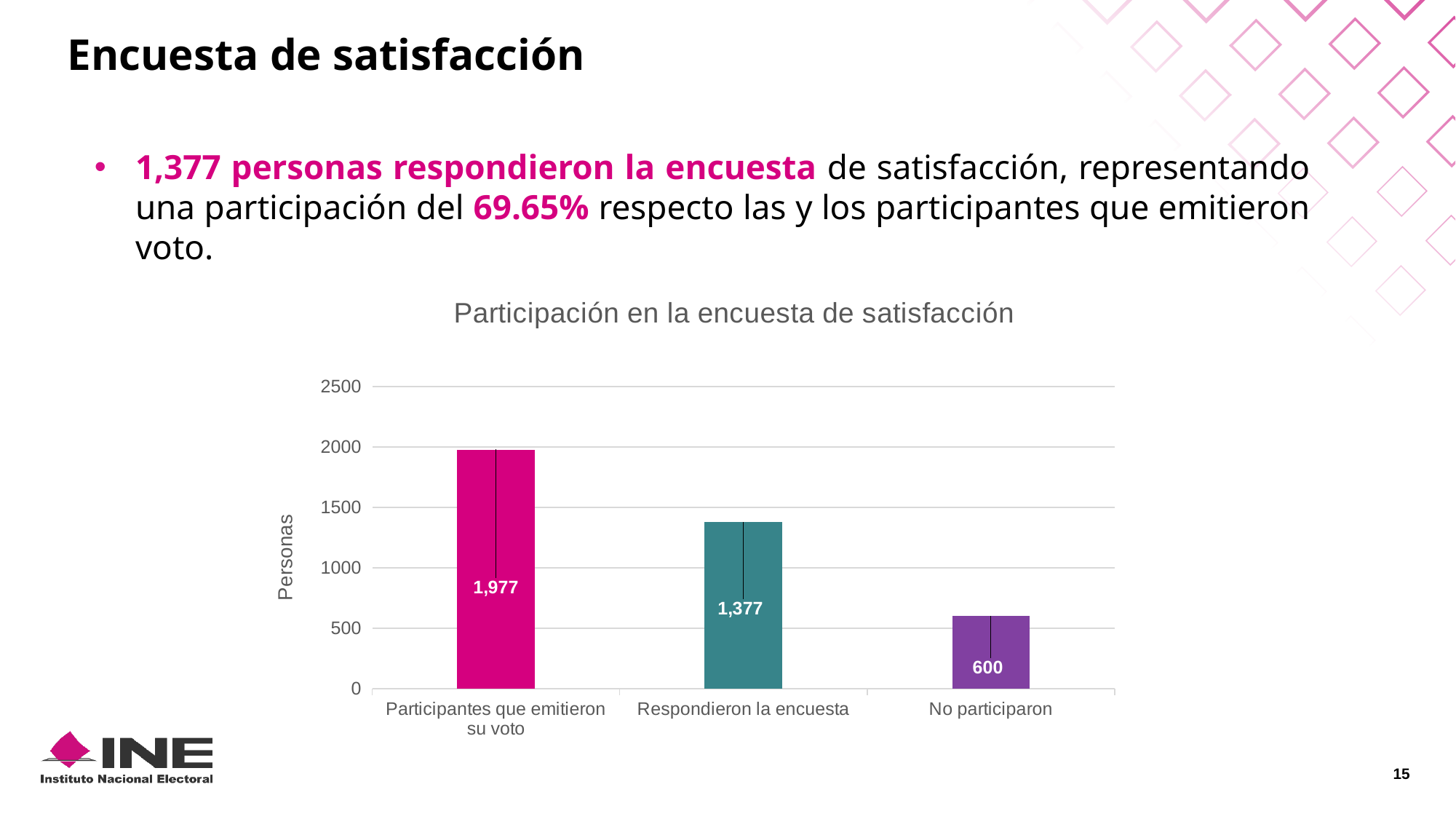
What kind of chart is shown on the slide? bar chart What is the difference between "Respondieron la encuesta" and "No participaron"? 777 What is the value for "No participaron"? 600 How many categories are shown on the x axis? 3 Which is larger, "Respondieron la encuesta" or "No participaron"? Respondieron la encuesta What is the title of the chart? Participación en la encuesta de satisfacción Which category has the lowest value? No participaron Is the value for "Respondieron la encuesta" greater or less than 1500? less What is the difference between "Participantes que emitieron su voto" and "Respondieron la encuesta"? 600 Which category has the highest value? Participantes que emitieron su voto What is the value for "Respondieron la encuesta"? 1,377 What is the value for "Participantes que emitieron su voto"? 1,977